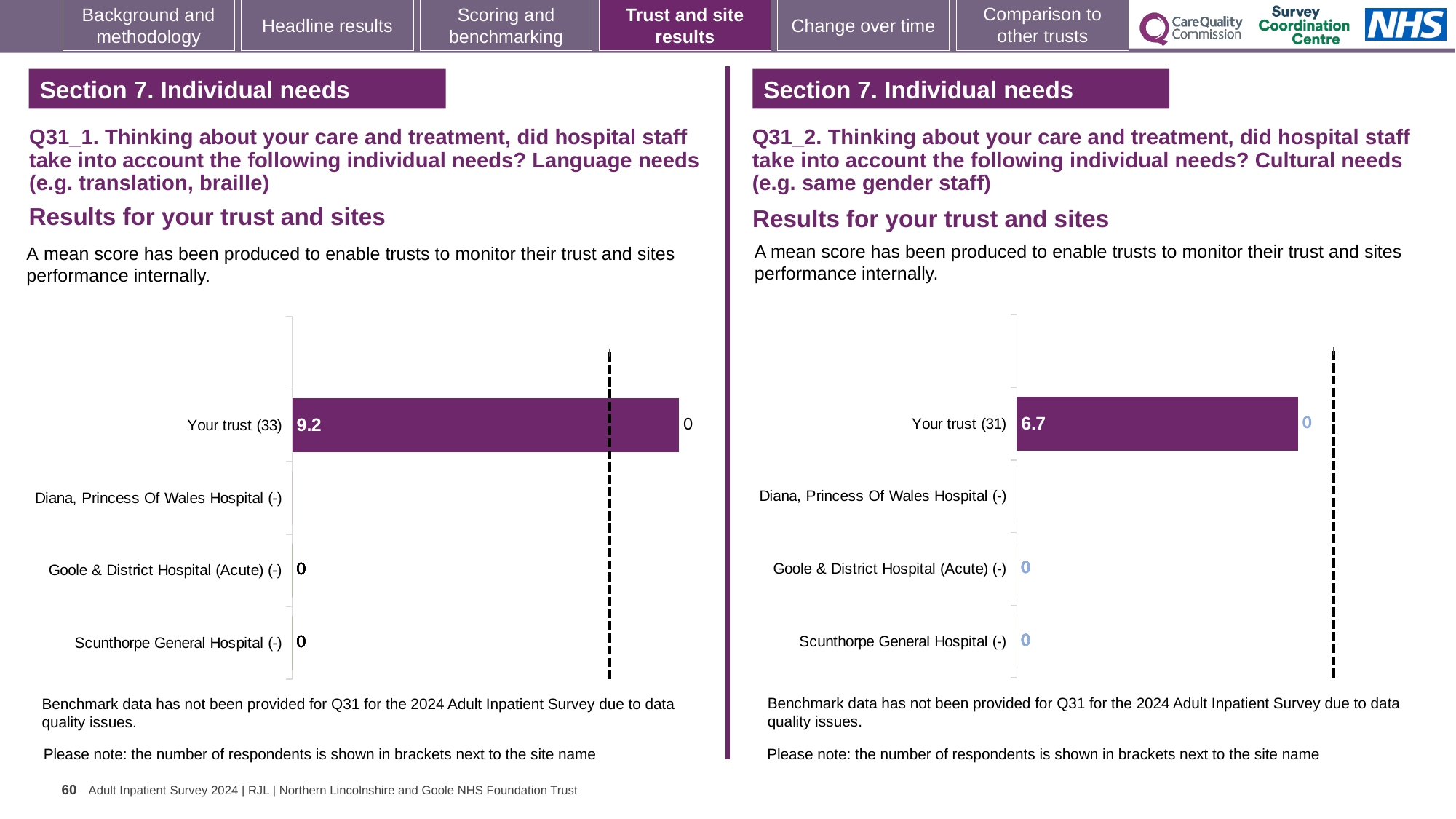
How many categories are listed on the right chart (Q31_2, Cultural needs)? 4 On the left chart (Q31_1, Language needs), how many respondents are shown in brackets next to Your trust? 33 What type of chart is used on the left side of the slide (Q31_1)? Bar chart On the right chart (Q31_2, Cultural needs), how many respondents are shown in brackets next to Your trust? 31 On the right chart (Q31_2, Cultural needs), which category has the highest mean score? Your trust (31) How many categories are listed on the left chart (Q31_1, Language needs)? 4 Is the Your trust score higher on the left chart (Q31_1, Language needs) or on the right chart (Q31_2, Cultural needs)? Left chart (Q31_1, Language needs) On the left chart (Q31_1, Language needs), which category has the highest mean score? Your trust (33) On the right chart (Q31_2, Cultural needs), what is the mean score for Your trust? 6.7 What is the difference between the Your trust score on the left chart (Q31_1) and the Your trust score on the right chart (Q31_2)? 2.5 On the left chart (Q31_1, Language needs), what is the mean score for Your trust? 9.2 On the right chart (Q31_2, Cultural needs), what value is shown for Scunthorpe General Hospital? 0